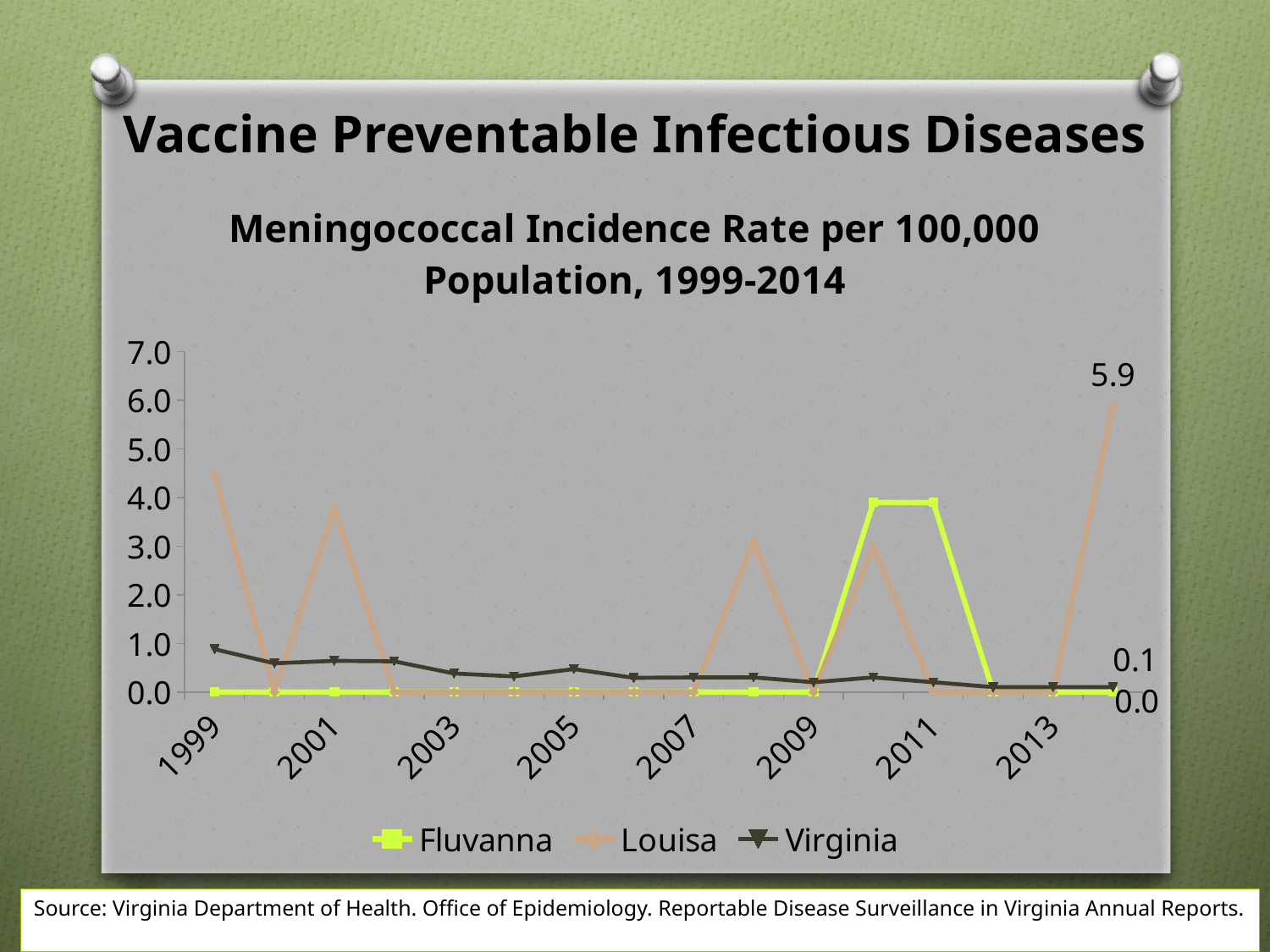
How many series does the legend list? 3 What is the title of the chart? Meningococcal Incidence Rate per 100,000 Population, 1999-2014 Is the value for Louisa in 1999 greater or less than 4.0? greater Does the Virginia line rise or fall overall from 1999 to 2014? fall What is the meningococcal incidence rate for Louisa in 2014? 5.9 What is the meningococcal incidence rate for Fluvanna in 2014? 0.0 What type of chart is shown on the slide? Line chart In 2014, which is larger, the rate for Louisa or the rate for Virginia? Louisa What is the meningococcal incidence rate for Virginia in 2014? 0.1 What is the difference between the Louisa and Virginia rates in 2014? 5.8 Which series reaches the highest value on the chart? Louisa